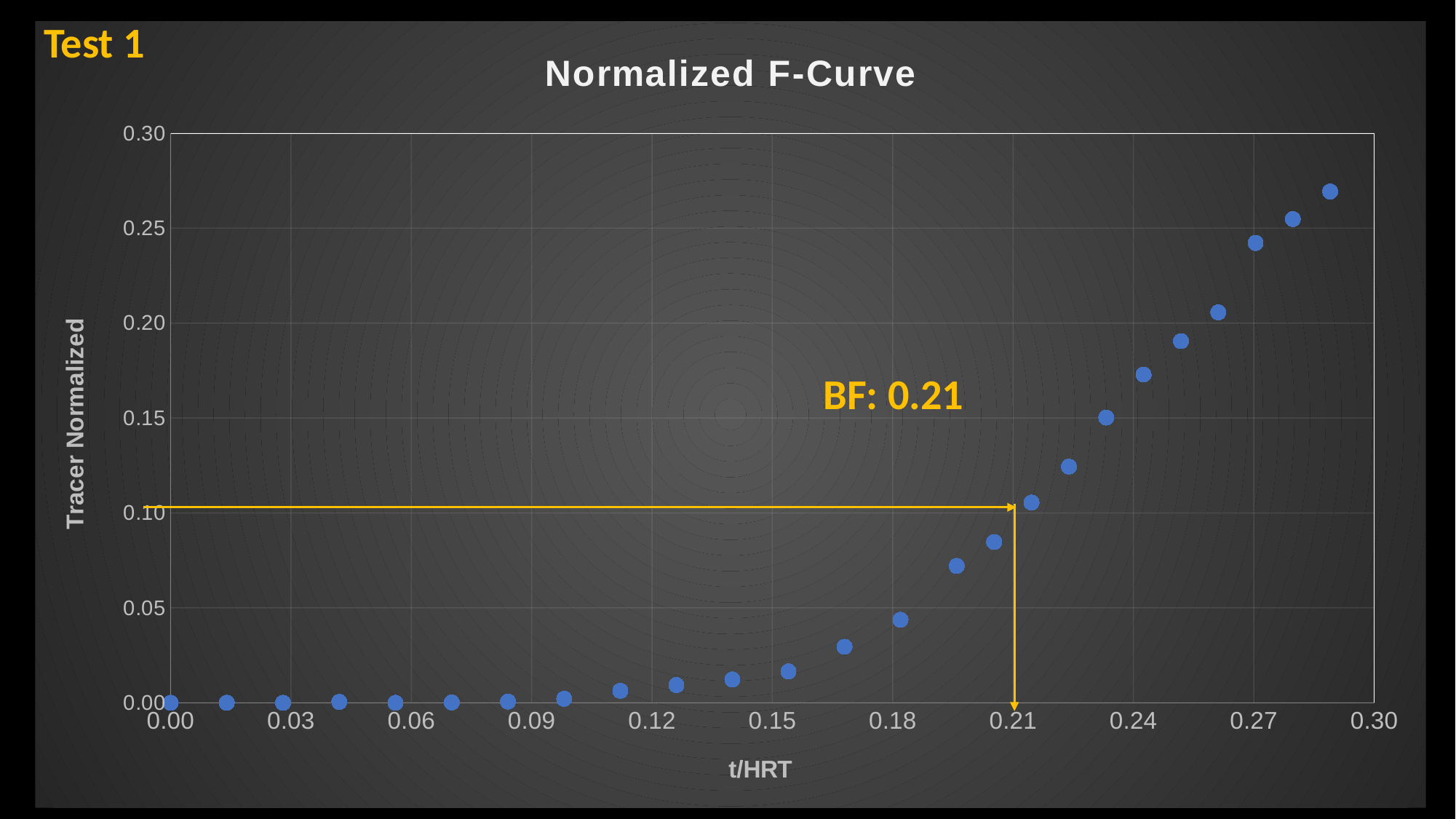
What kind of chart is shown on the slide? scatter chart Which has the larger Tracer Normalized value, t/HRT 0.27 or t/HRT 0.15? t/HRT 0.27 Is the value for t/HRT 0.18 greater or less than 0.10? less At which end of the x axis does the highest Tracer Normalized value occur? the right end Is the value for t/HRT 0.24 greater or less than 0.15? greater Do the plotted values rise or fall as t/HRT increases? rise What is the title of the chart? Normalized F-Curve What is the maximum value shown on the y axis? 0.30 Is the value for t/HRT 0.15 greater or less than 0.05? less What BF value is annotated on the chart? 0.21 What is the label of the y axis? Tracer Normalized